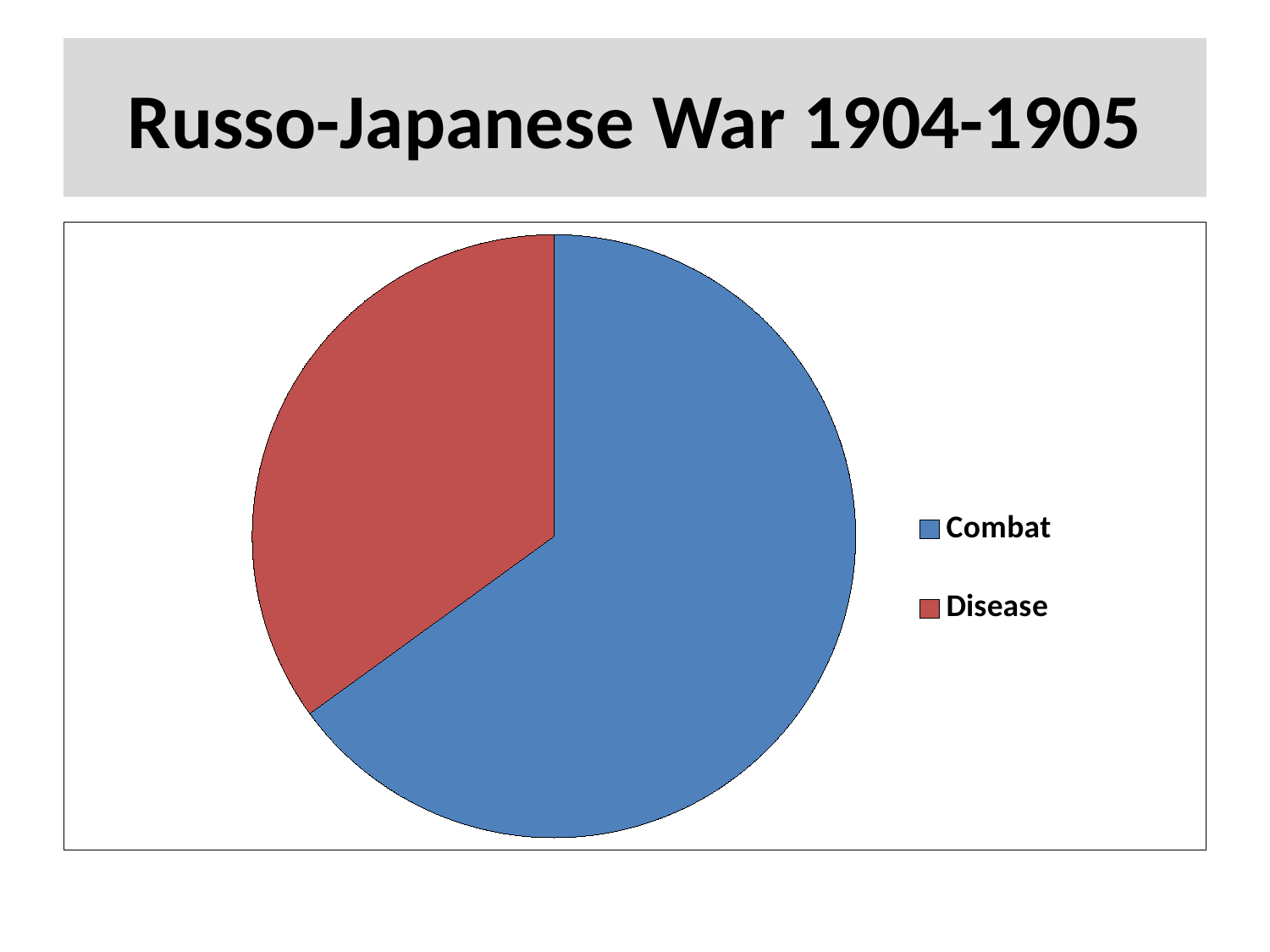
How many slices does the pie chart have? 2 Which category has the smallest slice of the pie? Disease Which category has the largest slice of the pie? Combat What kind of chart is shown on the slide? pie chart What colour is the Disease slice? red How many entries does the legend list? 2 What is the title of the slide containing the pie chart? Russo-Japanese War 1904-1905 Which is larger, the Combat slice or the Disease slice? Combat